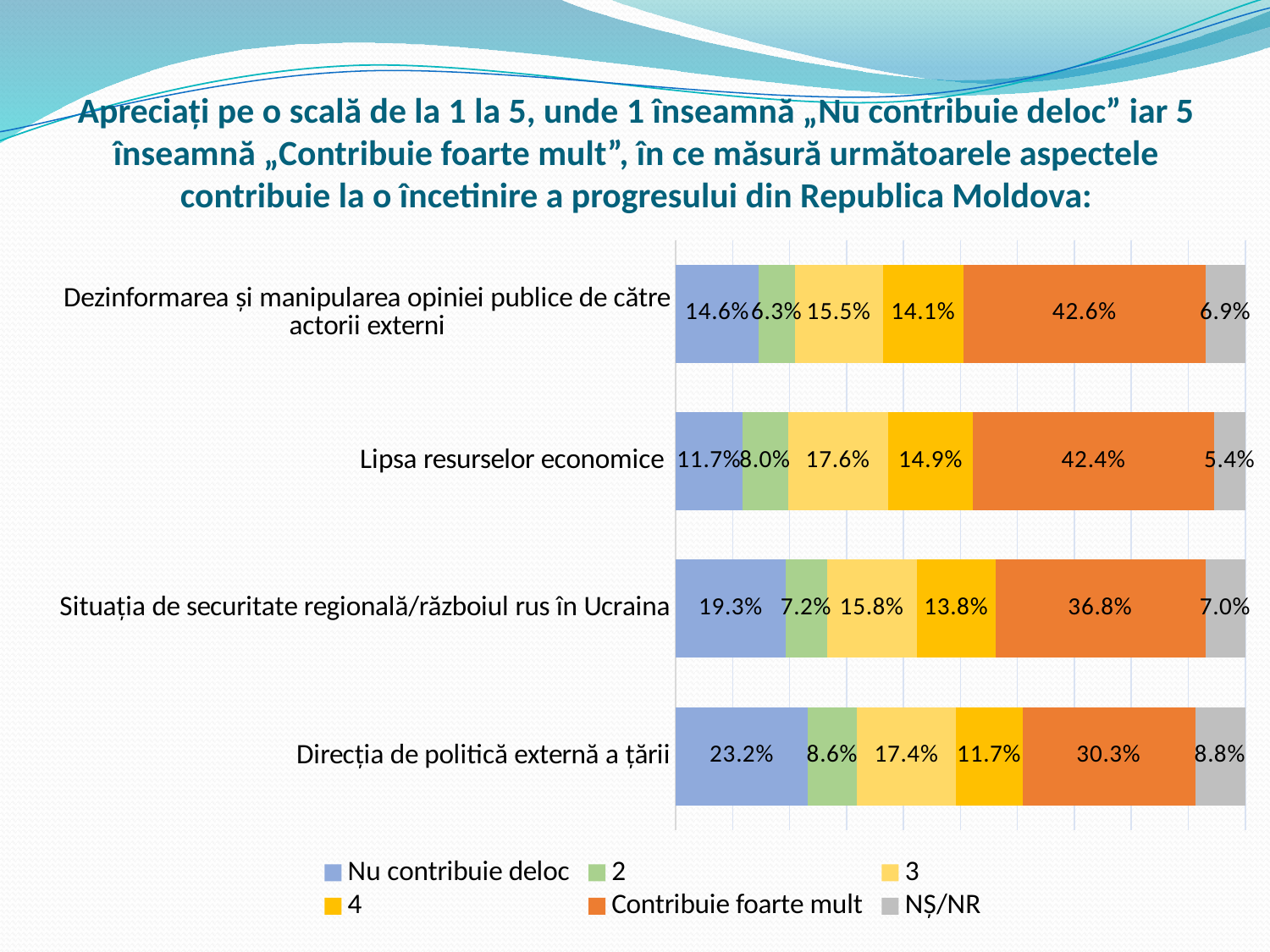
What kind of chart is shown on the slide? stacked bar chart Which category has the lowest "Contribuie foarte mult" value? Direcția de politică externă a țării What is the value of "Nu contribuie deloc" for "Direcția de politică externă a țării"? 23.2% Which category has the highest "Nu contribuie deloc" value? Direcția de politică externă a țării What is the value of series "3" for "Dezinformarea și manipularea opiniei publice de către actorii externi"? 15.5% What is the value of "Contribuie foarte mult" for "Lipsa resurselor economice"? 42.4% What is the difference between the "Contribuie foarte mult" values for "Dezinformarea și manipularea opiniei publice de către actorii externi" and "Situația de securitate regională/războiul rus în Ucraina"? 5.8% How many categories (aspects) are shown in the chart? 4 How many series does the legend list? 6 Which legend entry is shown in orange? Contribuie foarte mult What is the NȘ/NR value for "Situația de securitate regională/războiul rus în Ucraina"? 7.0% Which is larger: the "Nu contribuie deloc" value for "Situația de securitate regională/războiul rus în Ucraina" or for "Lipsa resurselor economice"? Situația de securitate regională/războiul rus în Ucraina